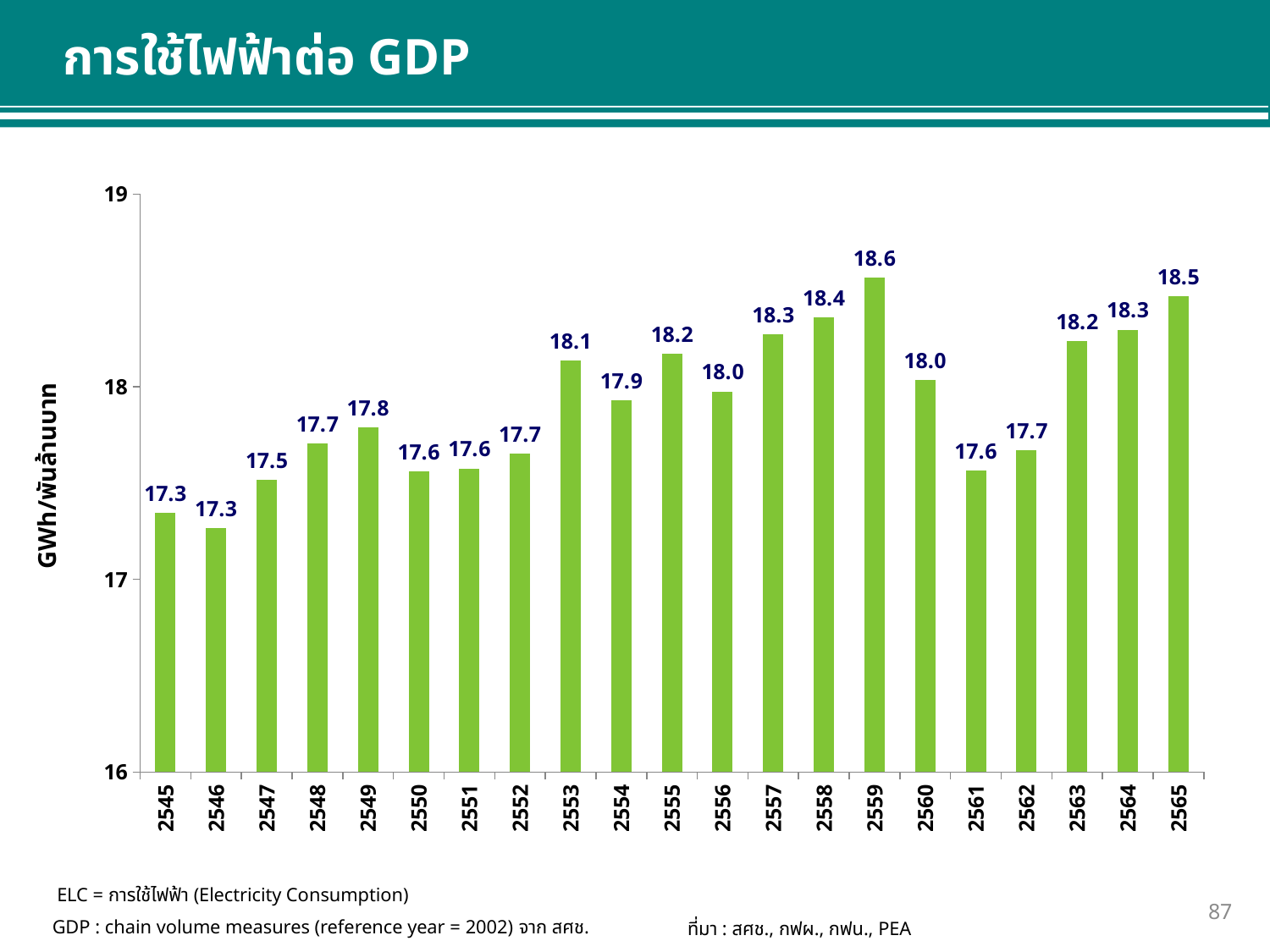
What is the label on the y axis? GWh/พันล้านบาท How many years are shown on the x axis? 21 Which is larger, the value for 2559 or the value for 2565? 2559 Is the value for 2553 greater or less than 18? greater What is the difference between the values for 2559 and 2545? 1.3 What type of chart is shown on the slide? Bar chart Which year has the highest value? 2559 What is the value for 2565? 18.5 Do the values rise or fall from 2545 to 2549? Rise What is the value for 2561? 17.6 What is the value for 2559? 18.6 What is the value for 2545? 17.3